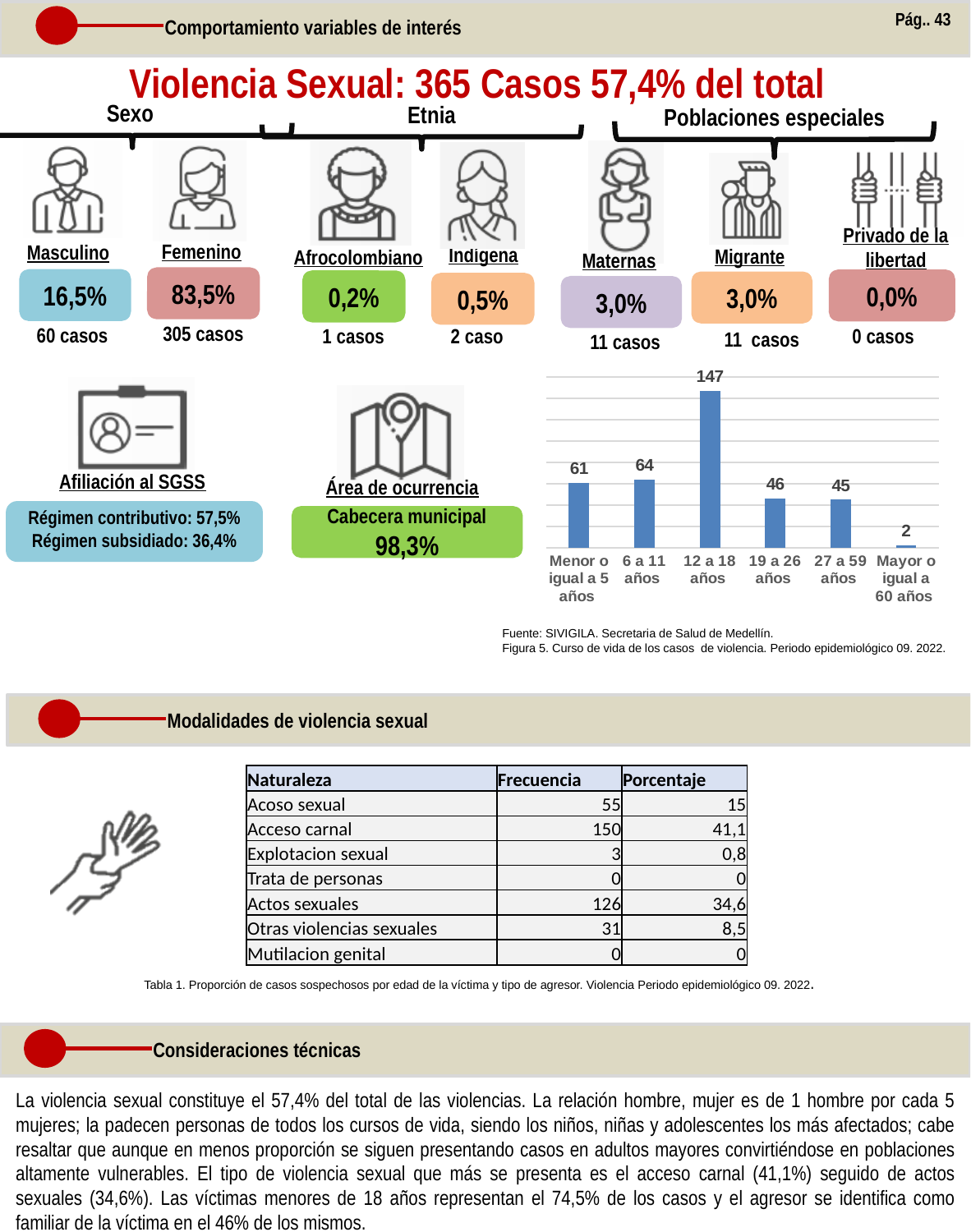
In the bar chart, which is larger: the value for '6 a 11 años' or for 'Menor o igual a 5 años'? 6 a 11 años In the bar chart, what is the value for the '12 a 18 años' age group? 147 In the bar chart, what is the value for '27 a 59 años'? 45 What type of chart is shown in Figura 5 (Curso de vida de los casos de violencia)? bar chart In the bar chart, what is the difference between the values for '19 a 26 años' and '27 a 59 años'? 1 In the bar chart, what is the value for 'Menor o igual a 5 años'? 61 In the bar chart, what is the difference between the values for '12 a 18 años' and '6 a 11 años'? 83 Which age group has the lowest value in the bar chart? Mayor o igual a 60 años According to the caption, what is the source of the data in the bar chart? SIVIGILA. Secretaria de Salud de Medellín Which age group has the highest value in the bar chart? 12 a 18 años In the bar chart, what is the value for 'Mayor o igual a 60 años'? 2 How many age groups are shown in the bar chart? 6